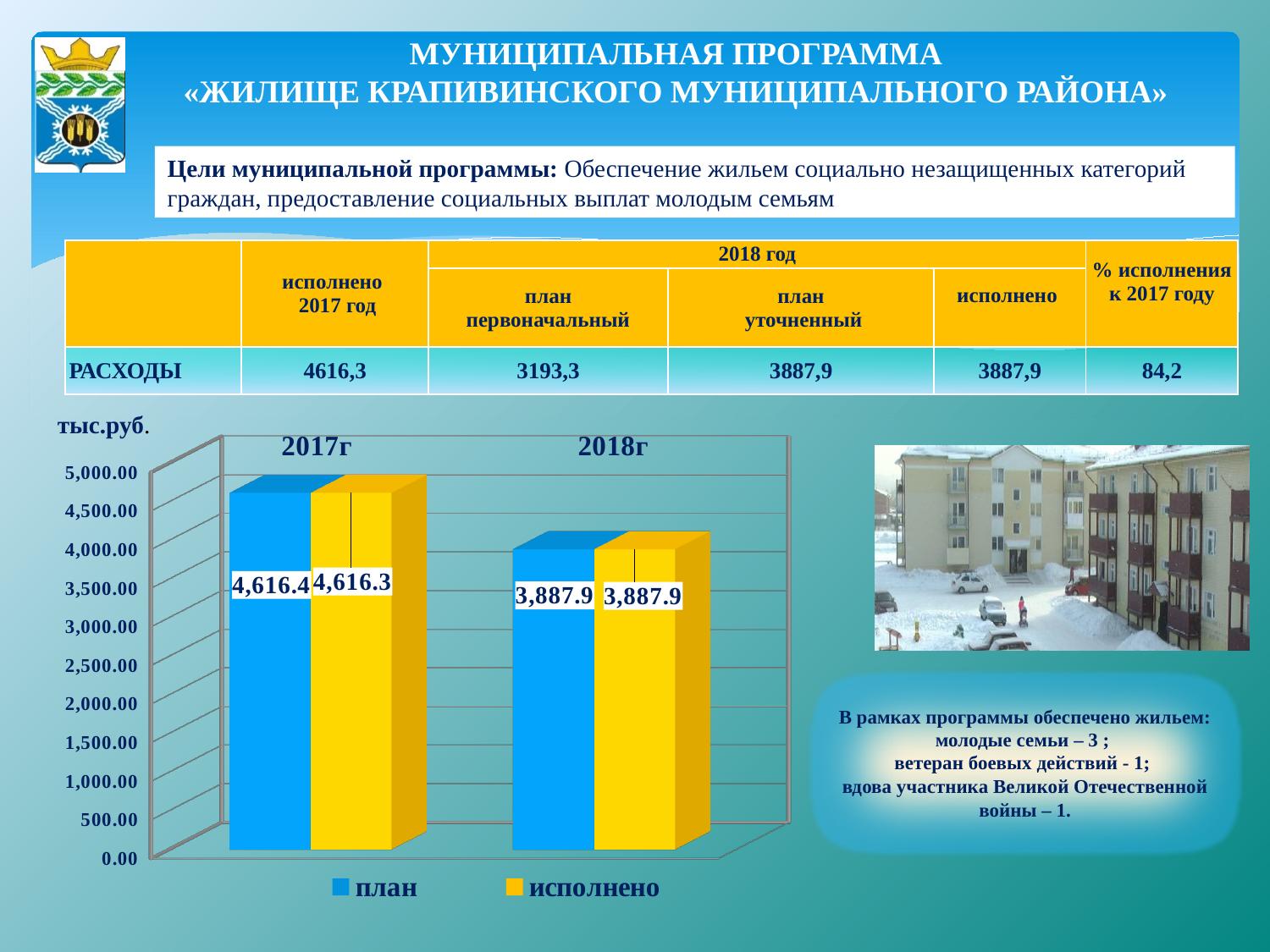
How many series does the chart legend list? 2 What is the difference between the план values for 2017г and 2018г? 728.5 Is the исполнено value for 2017г larger or smaller than the исполнено value for 2018г? larger Which year has the higher план value? 2017г Is the value of план for 2018г greater or less than 3,500.00? greater What is the value of план for 2017г? 4,616.4 What is the value of исполнено for 2017г? 4,616.3 What is the value of план for 2018г? 3,887.9 What kind of chart is shown on the slide? bar chart Which year has the lower исполнено value? 2018г What is the value of исполнено for 2018г? 3,887.9 How many year categories are shown on the x axis of the chart? 2